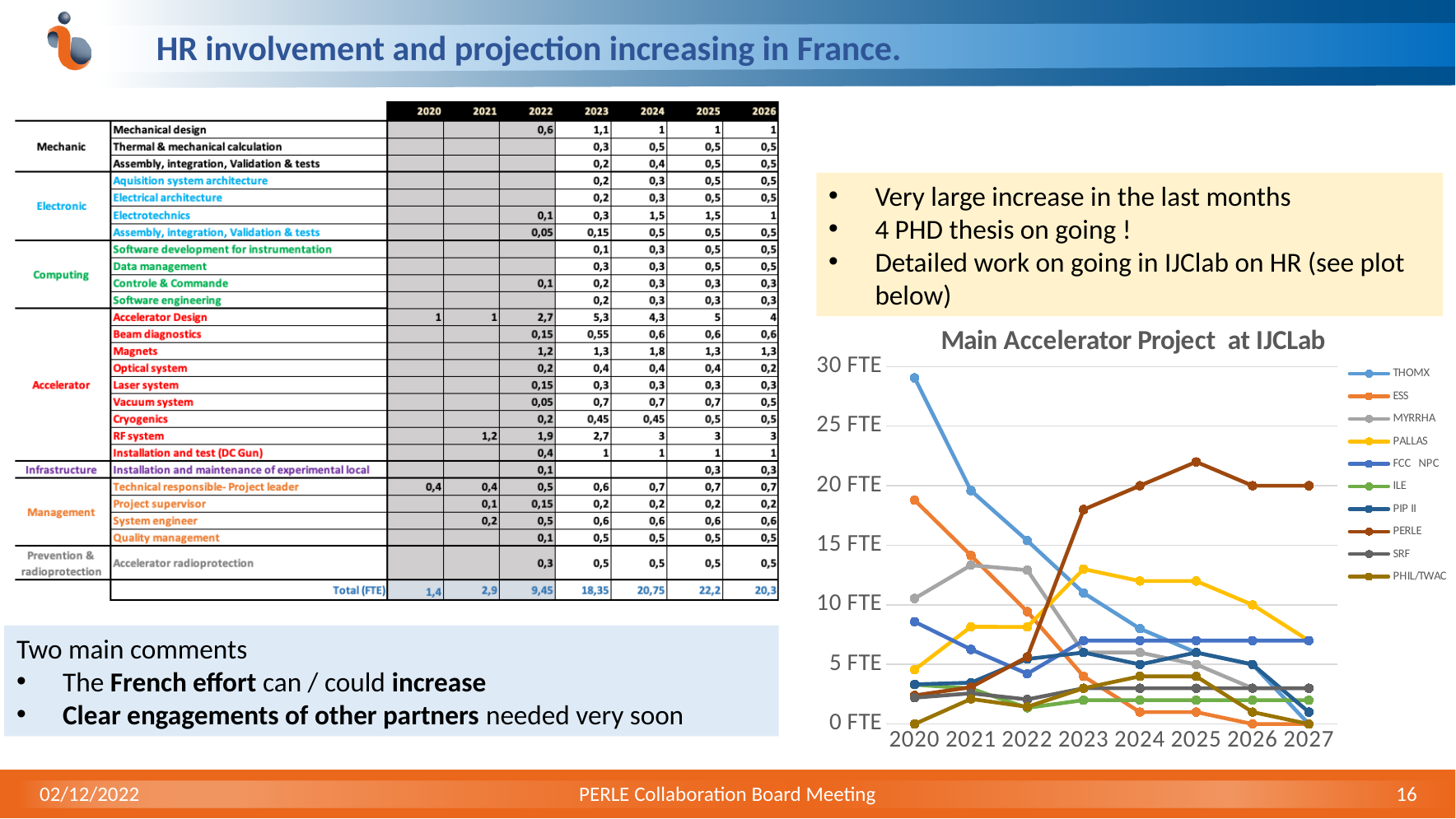
In the 'Main Accelerator Project at IJCLab' chart, which series has the lowest value in 2020? PHIL/TWAC What kind of chart is 'Main Accelerator Project at IJCLab'? line chart In the 'Main Accelerator Project at IJCLab' chart, which is larger in 2023, PERLE or THOMX? PERLE In the 'Main Accelerator Project at IJCLab' chart, which series has the highest value in 2020? THOMX In the 'Main Accelerator Project at IJCLab' chart, is the value for ESS in 2020 greater or less than 15 FTE? greater In the 'Main Accelerator Project at IJCLab' chart, does the THOMX series rise or fall from 2020 to 2027? fall In the 'Main Accelerator Project at IJCLab' chart, is the value for THOMX in 2020 greater or less than 25 FTE? greater How many series does the legend of the 'Main Accelerator Project at IJCLab' chart list? 10 In the 'Main Accelerator Project at IJCLab' chart, is the value for PALLAS in 2023 greater or less than 10 FTE? greater How many years are shown on the x axis of the 'Main Accelerator Project at IJCLab' chart? 8 What is the title of the chart on the slide? Main Accelerator Project at IJCLab In the 'Main Accelerator Project at IJCLab' chart, which series has the highest value in 2027? PERLE